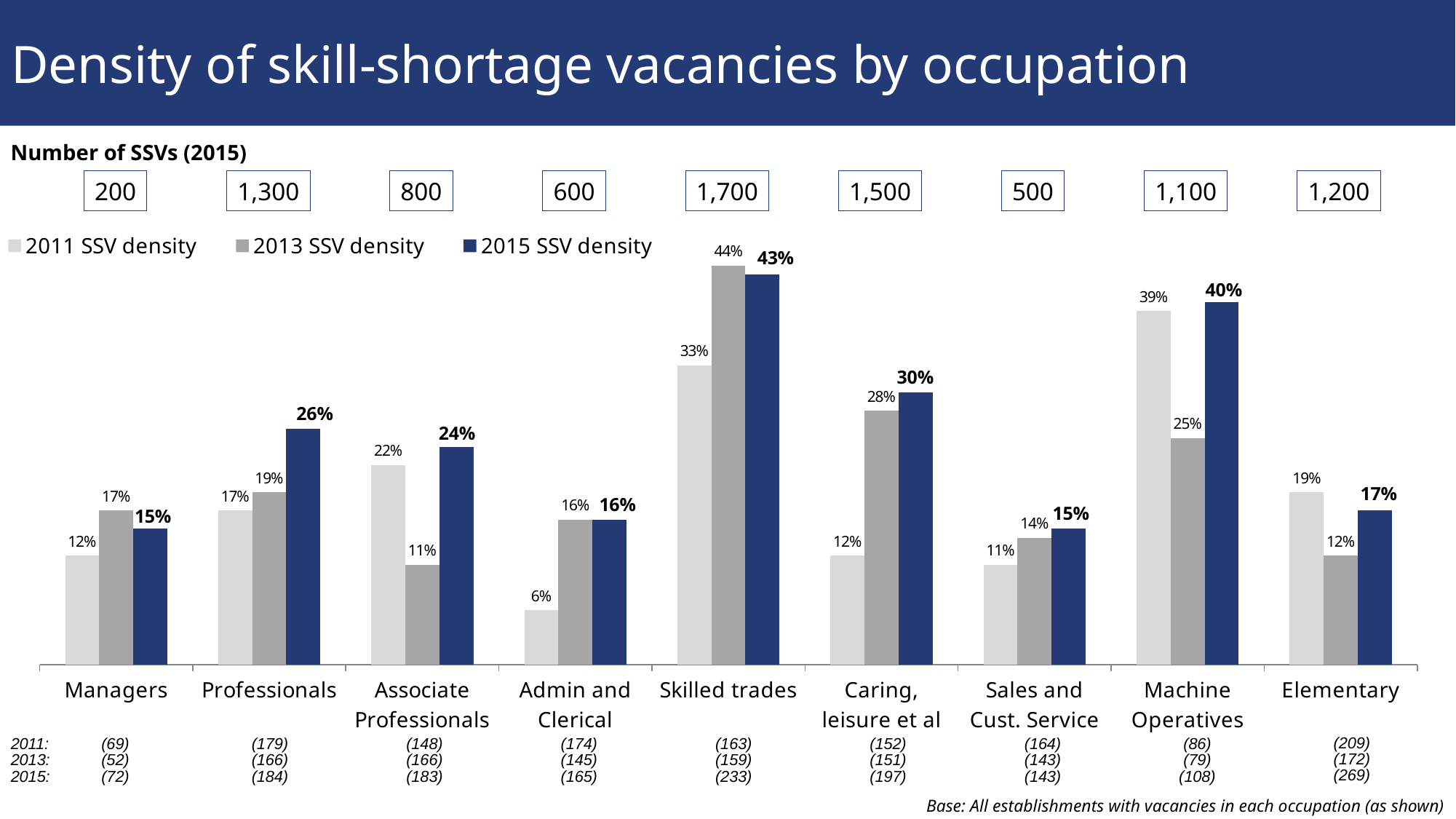
What is the difference between the 2015 and 2011 SSV density for Caring, leisure et al? 18% How many series does the legend list? 3 What is the number of SSVs (2015) shown for Skilled trades? 1,700 Which is larger: the 2013 SSV density for Professionals or the 2013 SSV density for Associate Professionals? Professionals What is the 2013 SSV density for Machine Operatives? 25% How many occupation categories are shown on the chart? 9 What is the 2011 SSV density for Admin and Clerical? 6% What kind of chart is shown on the slide? Bar chart What is the 2015 SSV density for Skilled trades? 43% Which series is shown in dark blue in the legend? 2015 SSV density Which occupation has the highest 2015 SSV density? Skilled trades Which occupation has the lowest 2011 SSV density? Admin and Clerical